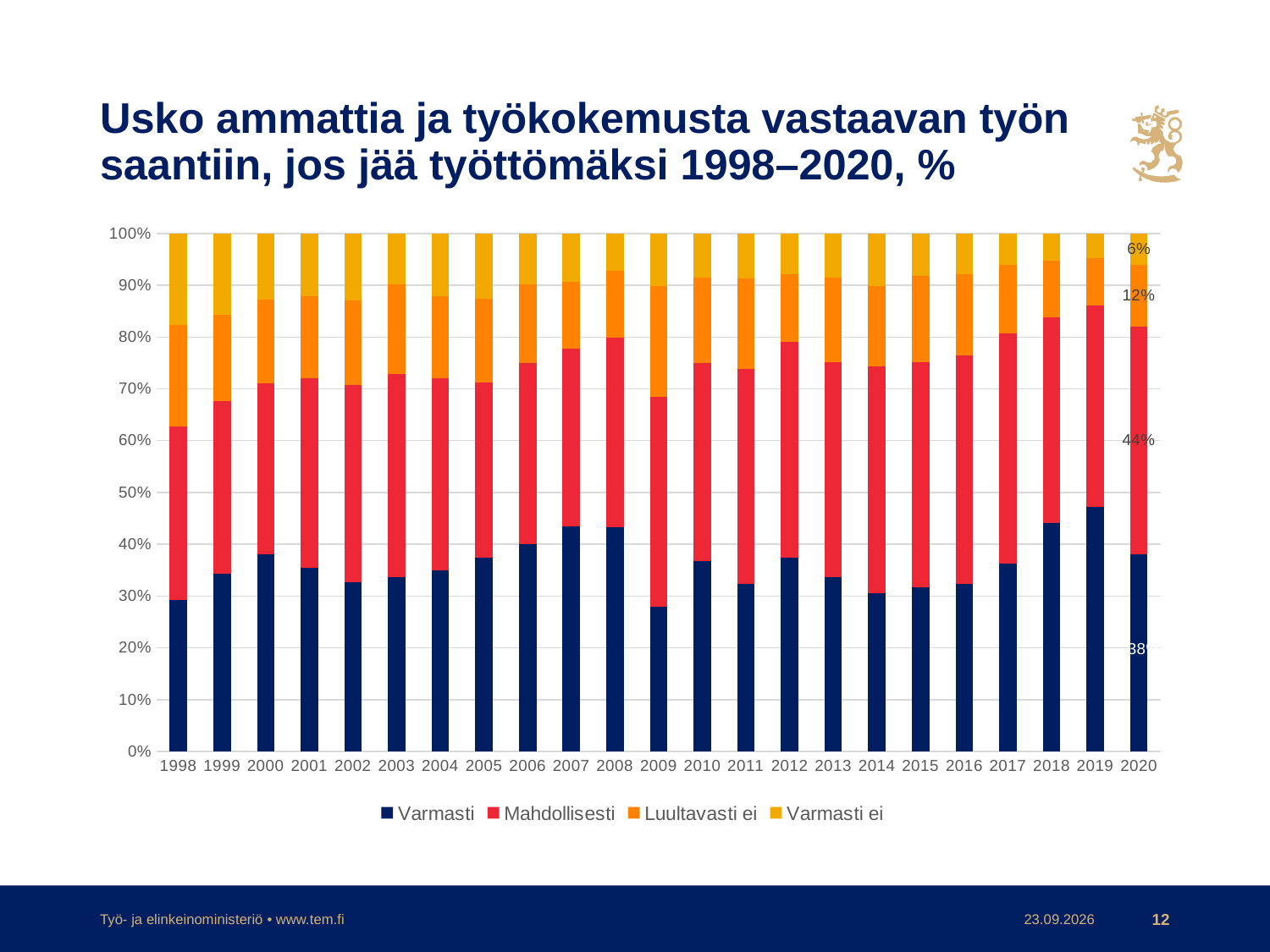
Which is larger, the Varmasti value for 2019 or for 2009? 2019 What is the value of Mahdollisesti for 2020? 44% What is the total of the stacked bar for 2020? 100% What is the value of Luultavasti ei for 2020? 12% Is the value of Varmasti for 2019 greater or less than 40%? greater What kind of chart is shown on the slide? bar chart Is the value of Varmasti for 2014 greater or less than 40%? less How many years are shown on the x axis? 23 In which year is the Varmasti segment the highest? 2019 What is the value of Varmasti for 2020? 38% What is the value of Varmasti ei for 2020? 6% How many series does the legend list? 4